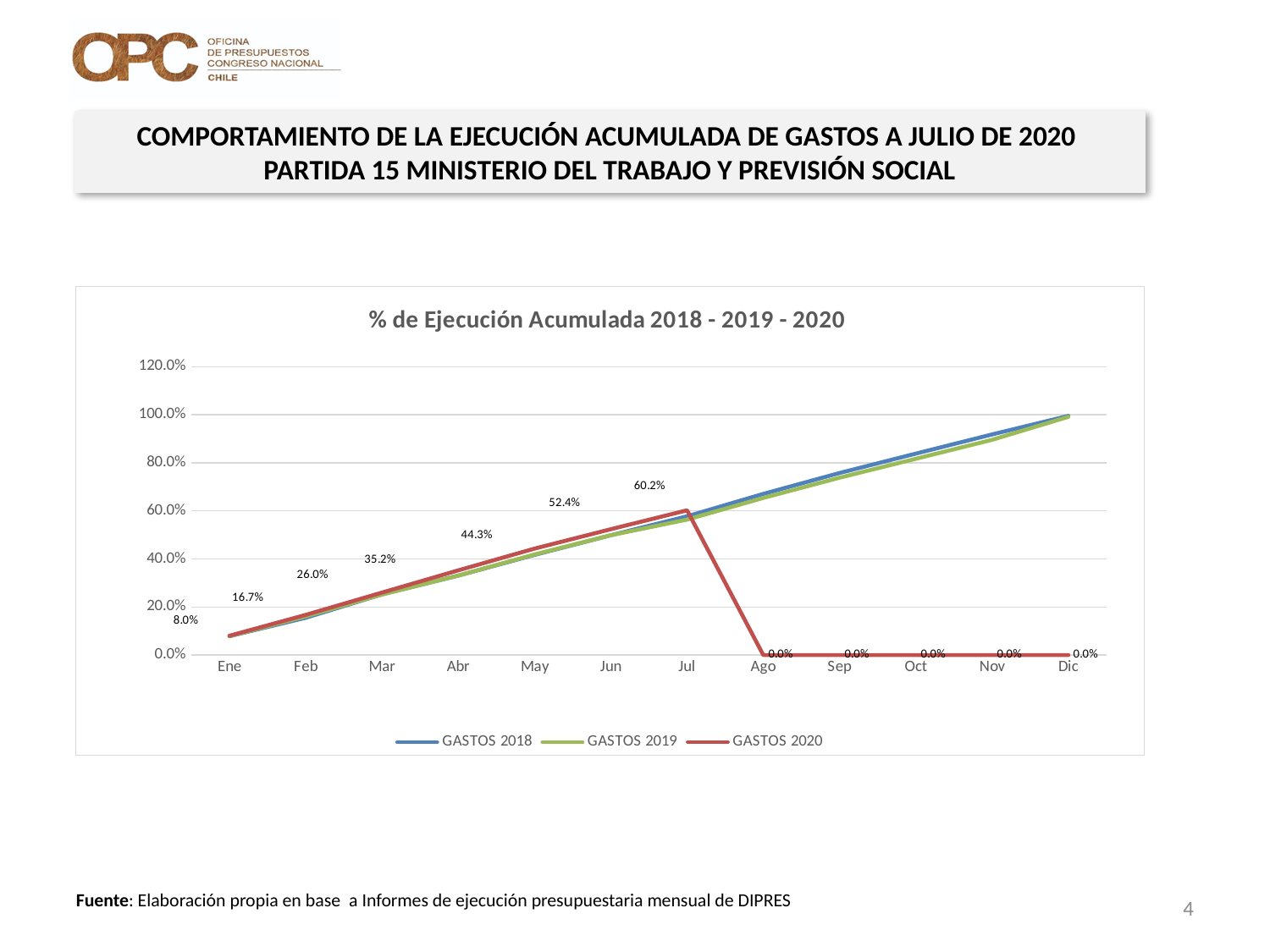
In which month does GASTOS 2020 reach its highest value? Jul What type of chart is shown on the slide? Line chart What is the value for GASTOS 2020 in Ago? 0.0% What is the value for GASTOS 2020 in Jul? 60.2% Does the GASTOS 2020 line rise or fall from Ene to Jul? Rise What is the difference between the GASTOS 2020 values for Jul and Jun? 7.8% What is the value for GASTOS 2020 in Ene? 8.0% What is the value for GASTOS 2020 in Abr? 35.2% How many months are shown on the x axis? 12 What is the title of the chart? % de Ejecución Acumulada 2018 - 2019 - 2020 Is the value for GASTOS 2018 in Dic greater or less than 80.0%? greater How many series does the legend list? 3